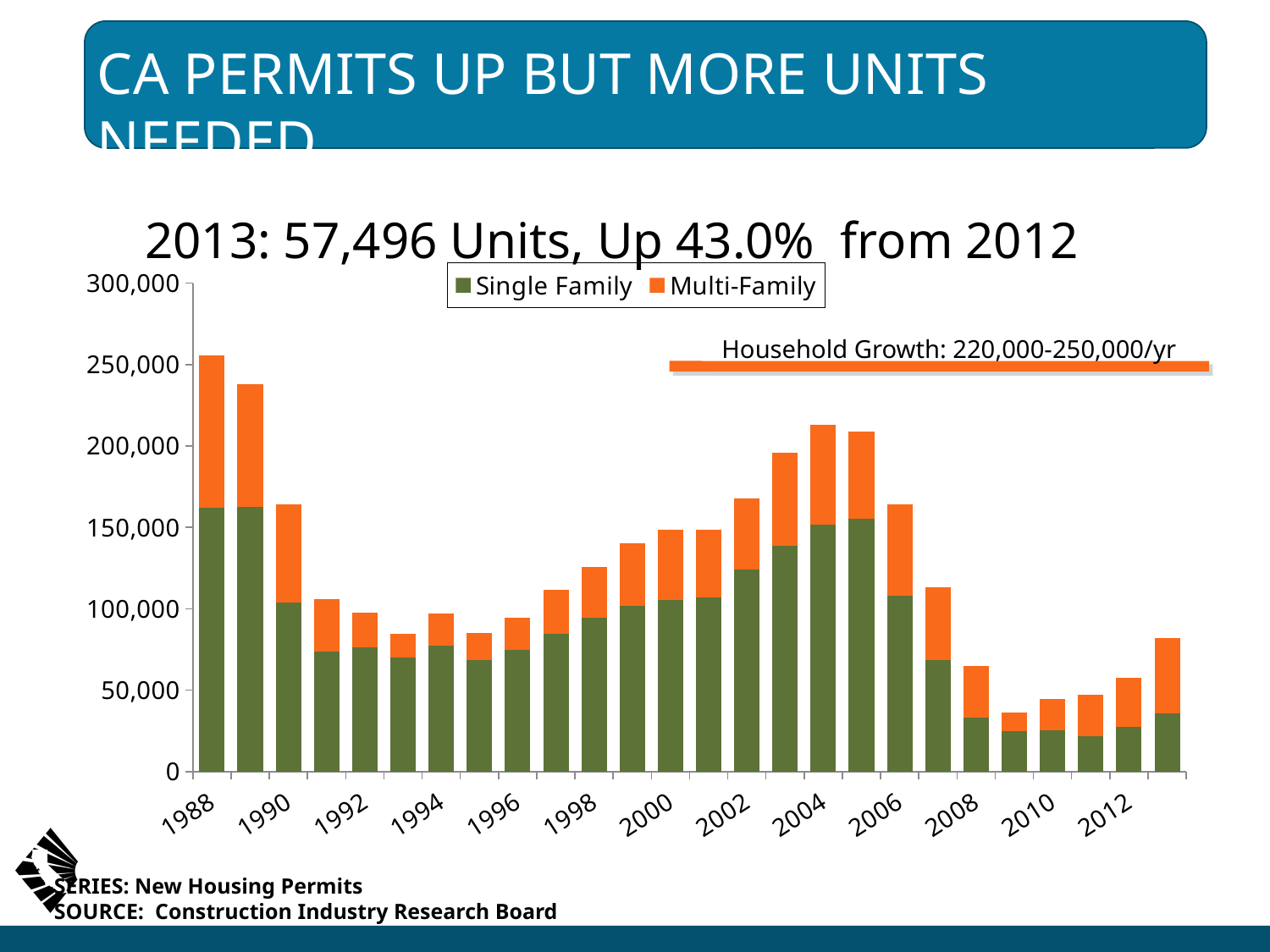
Which year has a larger total, 2004 or 2006? 2004 Is the total value for 1990 greater or less than 150,000? greater What are the two series named in the legend? Single Family and Multi-Family Is the total value for 2004 greater or less than 200,000? greater Do total permits rise or fall from 2009 to 2013? Rise How many series does the legend list? 2 What household growth range is annotated on the chart? 220,000-250,000/yr Is the total value for 2008 greater or less than 100,000? less What kind of chart is shown on the slide? Stacked bar chart Do total permits rise or fall from 2004 to 2009? Fall Which year has the highest total number of permits? 1988 Which year has the lowest total number of permits? 2009